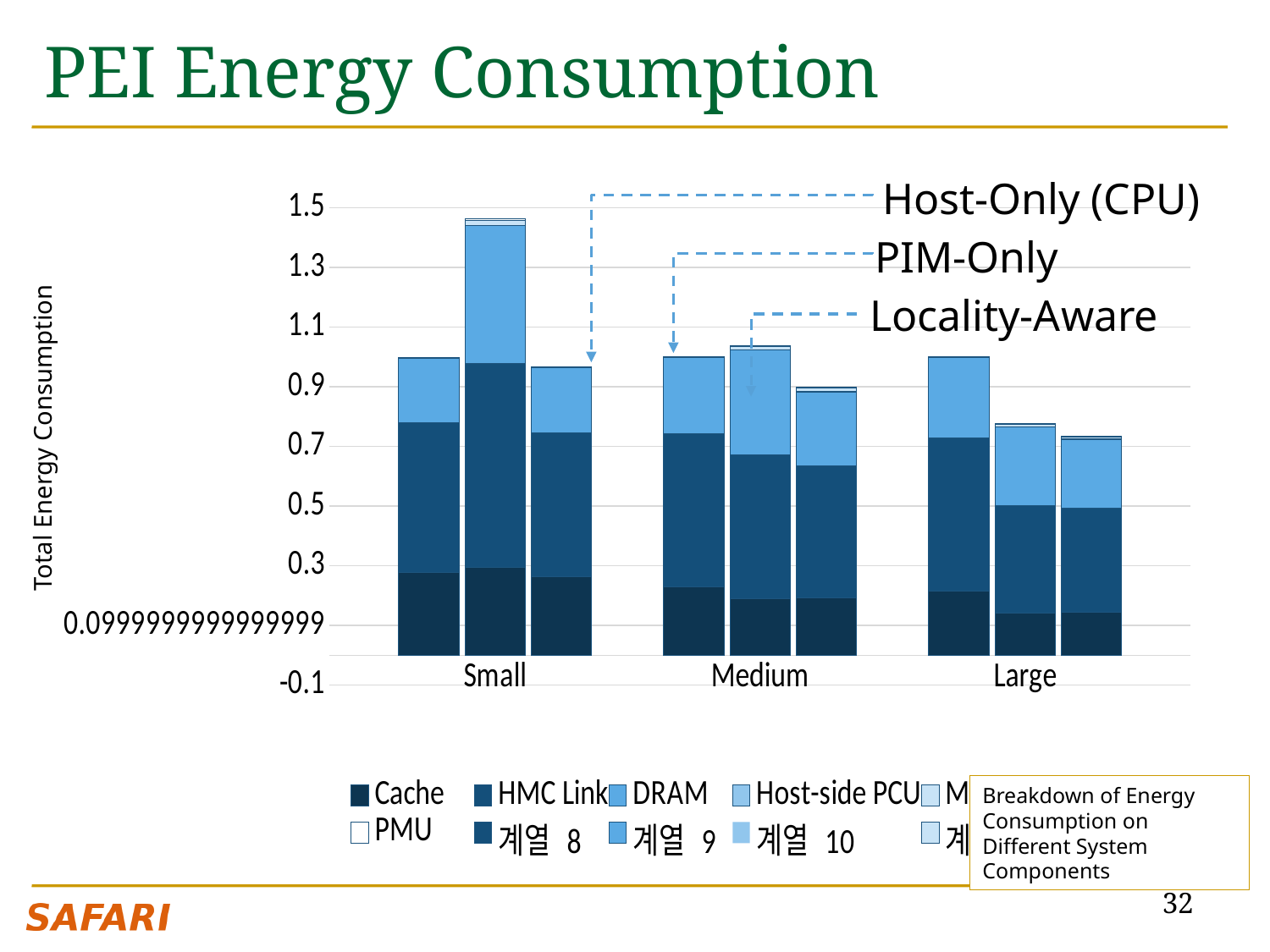
Do the Locality-Aware totals rise or fall from Small to Large? fall Which configuration has the highest total energy consumption for Small? PIM-Only What kind of chart is shown on the slide? bar chart Is the total for Locality-Aware in the Large group greater or less than 0.9? less What is the label on the y axis? Total Energy Consumption Is the total for PIM-Only in the Large group greater or less than 0.9? less Is the total for Locality-Aware in the Small group greater or less than 1.1? less How many categories are shown on the x axis? 3 Which configuration has the lowest total energy consumption for Large? Locality-Aware In the Large group, which is larger: the Host-Only (CPU) total or the Locality-Aware total? Host-Only (CPU) In the Medium group, which is larger: the PIM-Only total or the Locality-Aware total? PIM-Only